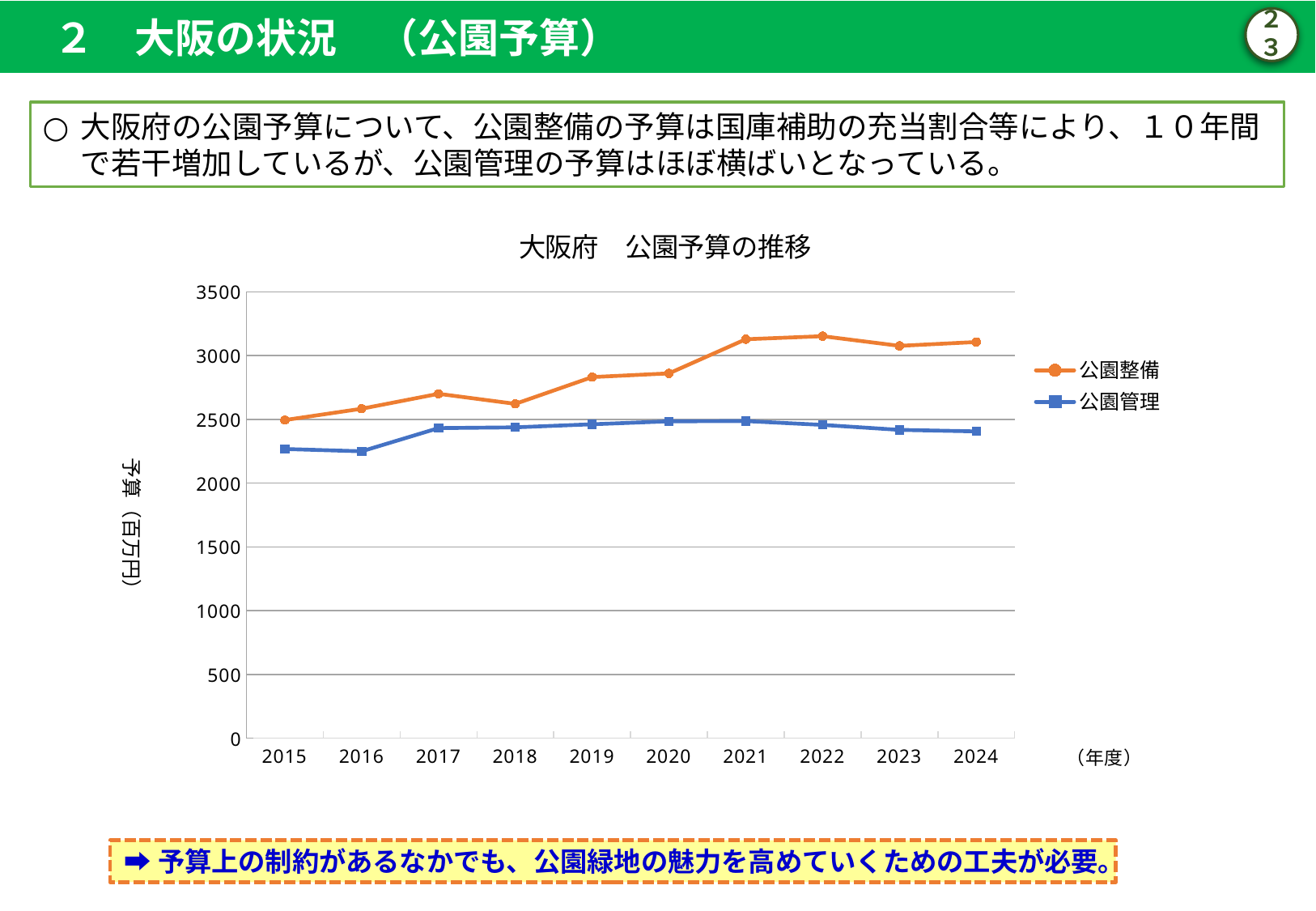
What is the label of the vertical axis? 予算（百万円） How many years are plotted along the x axis? 10 How many series does the legend list? 2 Is the value for 公園整備 in 2021 greater or less than 3000? greater Is the value for 公園整備 in 2024 greater or less than 3000? greater What is the title of the chart? 大阪府 公園予算の推移 Does the value for 公園整備 generally rise or fall from 2015 to 2024? rise Is the value for 公園整備 in 2019 greater or less than 2500? greater What kind of chart is shown on the slide? line chart In which year is the value for 公園整備 the lowest? 2015 In 2020, which series has the larger value, 公園整備 or 公園管理? 公園整備